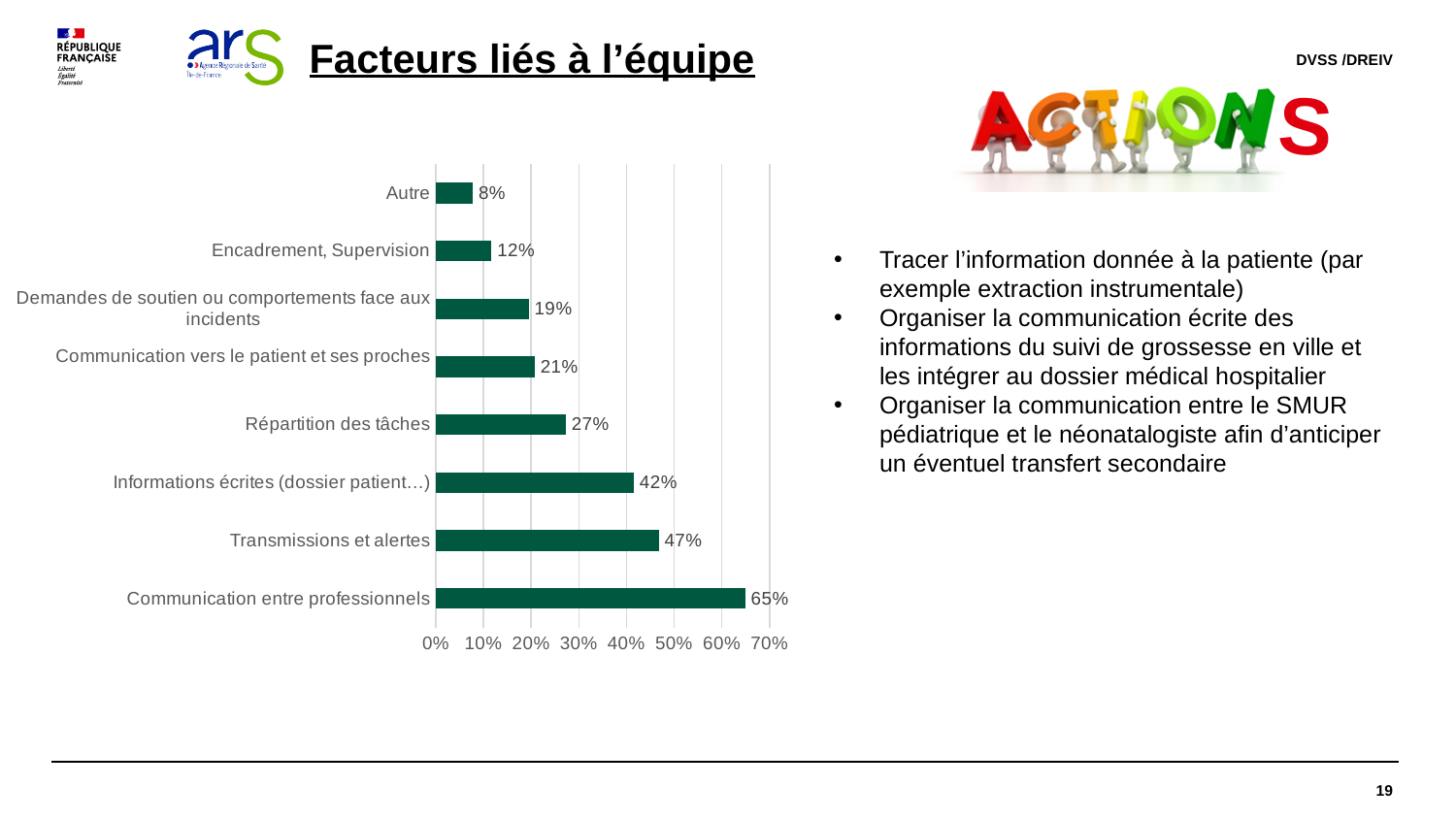
Which category has the highest value? Communication entre professionnels Which category has the lowest value? Autre What is the value for Répartition des tâches? 27% What is the value for Communication entre professionnels? 65% What is the difference between Communication entre professionnels and Transmissions et alertes? 18% What is the value for Encadrement, Supervision? 12% What kind of chart is shown on the slide? bar chart Which is larger: Informations écrites (dossier patient…) or Communication vers le patient et ses proches? Informations écrites (dossier patient…) What is the value for Transmissions et alertes? 47% Is the value for Demandes de soutien ou comportements face aux incidents greater or less than 20%? less What is the maximum value shown on the horizontal axis? 70% How many categories are shown in the chart? 8